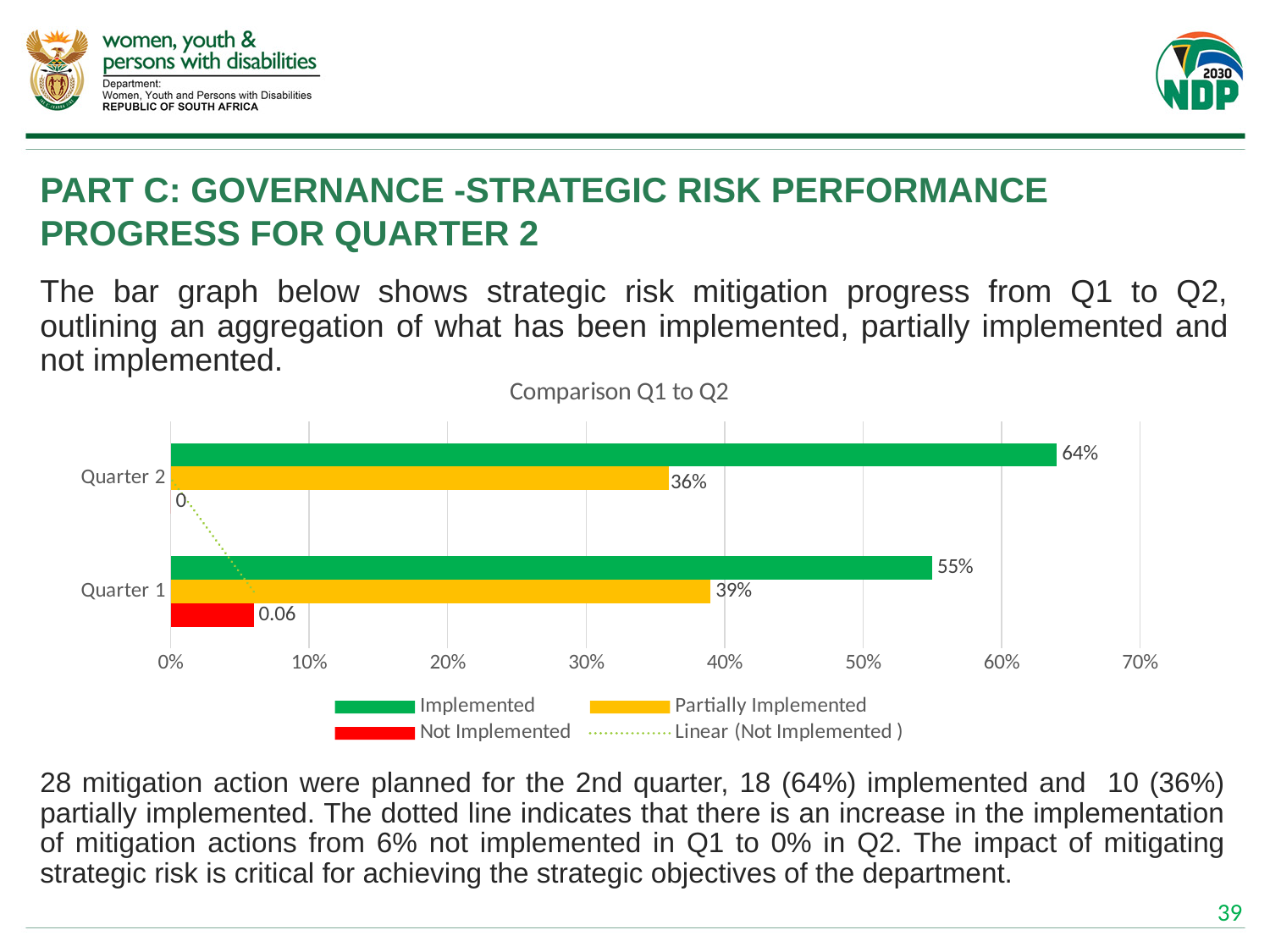
What is the Partially Implemented value for Quarter 1? 39% What is the Implemented value for Quarter 1? 55% How many entries does the chart legend list? 4 What is the Implemented value for Quarter 2? 64% How many quarters are shown on the chart? 2 What type of chart is shown on the slide? bar chart Which quarter has the higher Implemented value? Quarter 2 Is the Partially Implemented value for Quarter 2 larger or smaller than that for Quarter 1? smaller What is the difference between the Implemented values for Quarter 2 and Quarter 1? 9% Is the Implemented value for Quarter 2 greater or less than 60%? greater What data label is shown on the Not Implemented bar for Quarter 1? 0.06 What data label is shown for Not Implemented in Quarter 2? 0